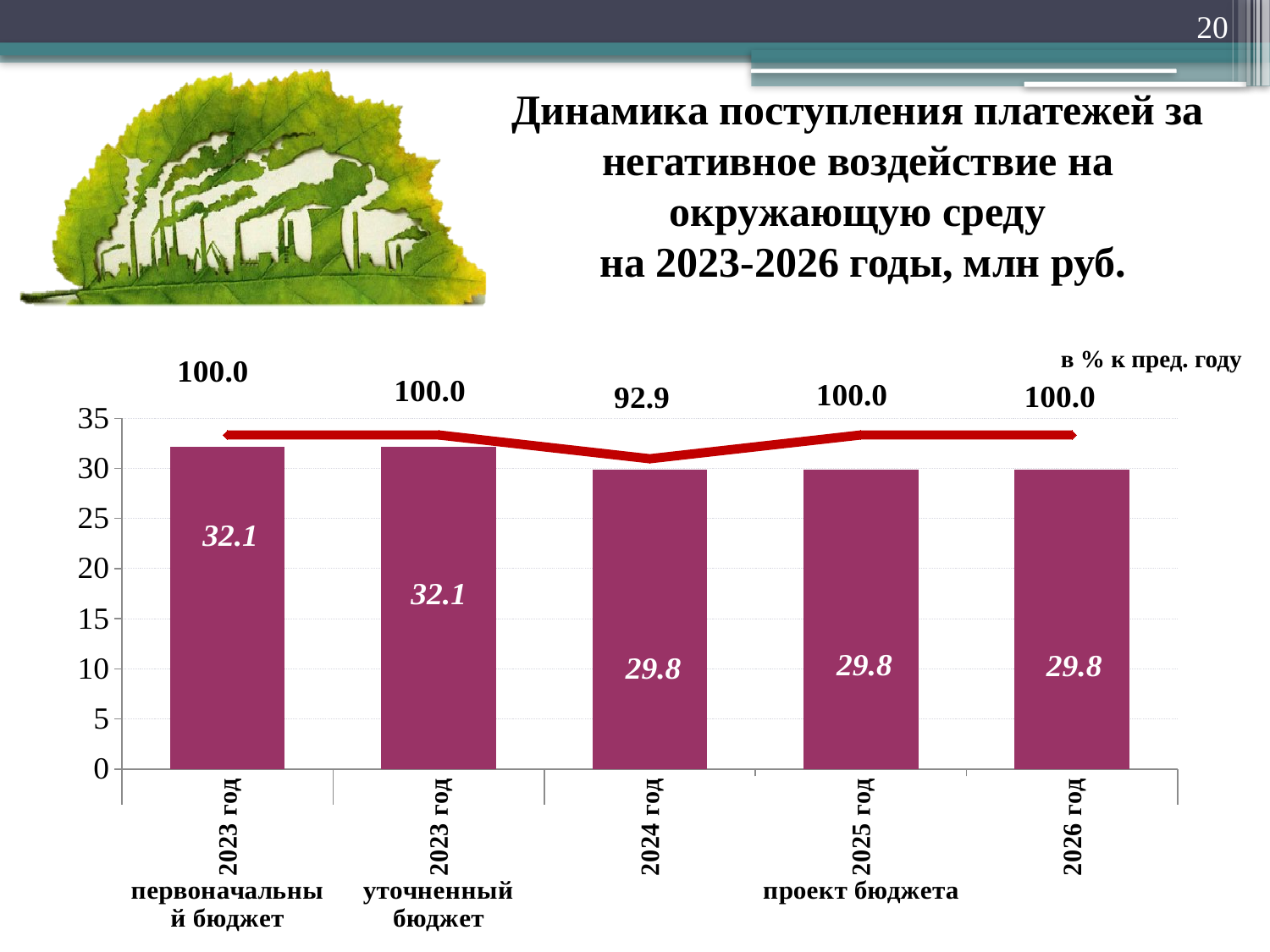
What is the difference between the value for 2023 год (уточненный бюджет) and the value for 2024 год? 2.3 What is the value for 2023 год (первоначальный бюджет)? 32.1 What kind of chart is shown on the slide? combination bar and line chart Is the value for 2025 год greater or less than 30? less What unit is stated in the chart title? млн руб. Do the bar values rise or fall from 2023 год (уточненный бюджет) to 2024 год? fall What percentage to the previous year (в % к пред. году) is shown for 2025 год? 100.0 Which is larger, the value for 2023 год (уточненный бюджет) or the value for 2025 год? 2023 год (уточненный бюджет) What is the value for 2024 год? 29.8 How many bars are plotted in the chart? 5 What percentage to the previous year (в % к пред. году) is shown for 2024 год? 92.9 What is the value for 2026 год? 29.8